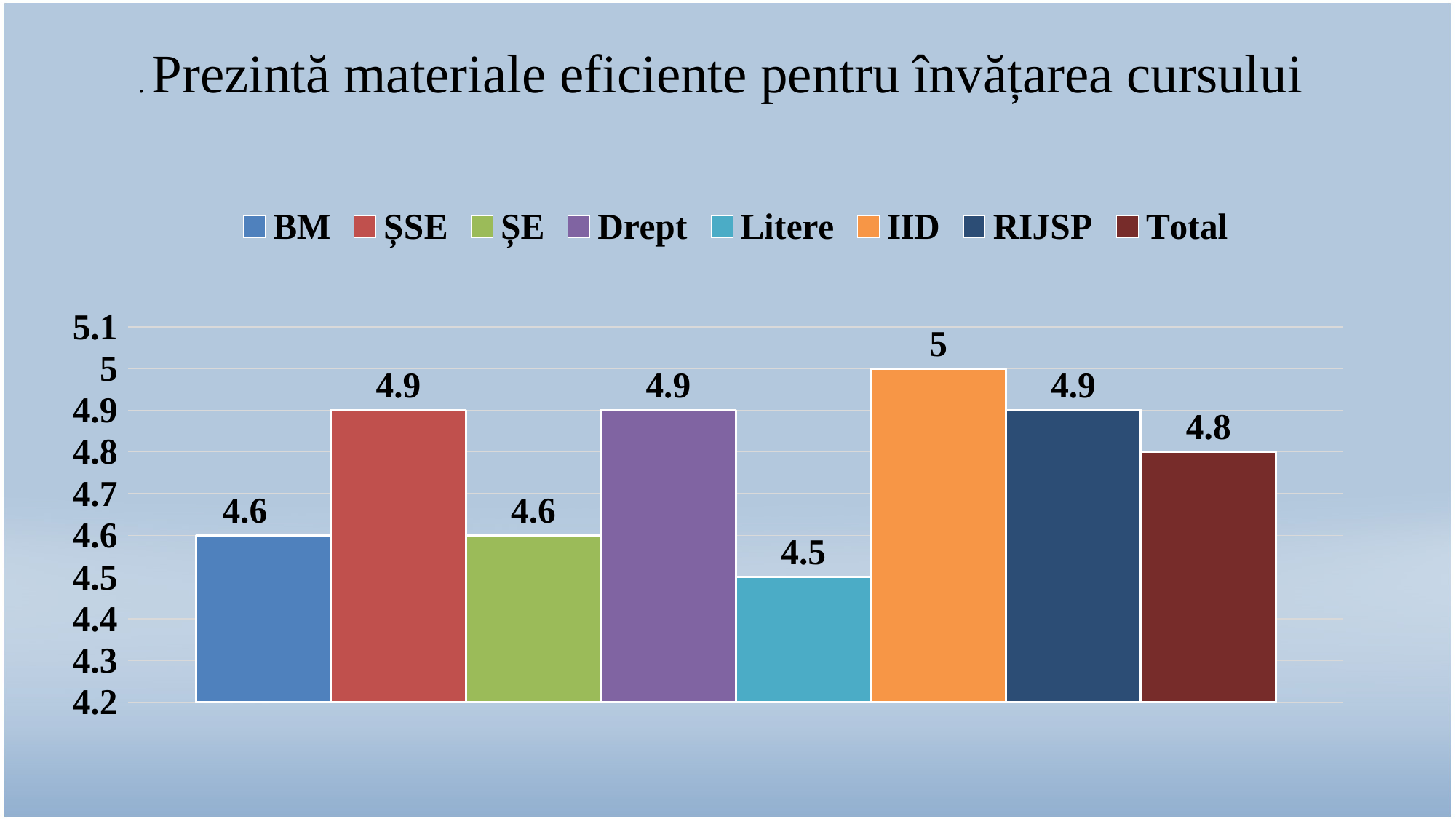
Which is larger, the value for Drept or the value for Total? Drept What is the difference between the values for IID and Litere? 0.5 What is the difference between the values for ȘSE and ȘE? 0.3 Which category has the highest value? IID What is the value for Total? 4.8 What is the value for BM? 4.6 How many bars are shown in the chart? 8 Which category has the lowest value? Litere What is the value for Litere? 4.5 What kind of chart is shown on the slide? Bar chart How many entries does the legend list? 8 What is the value for IID? 5